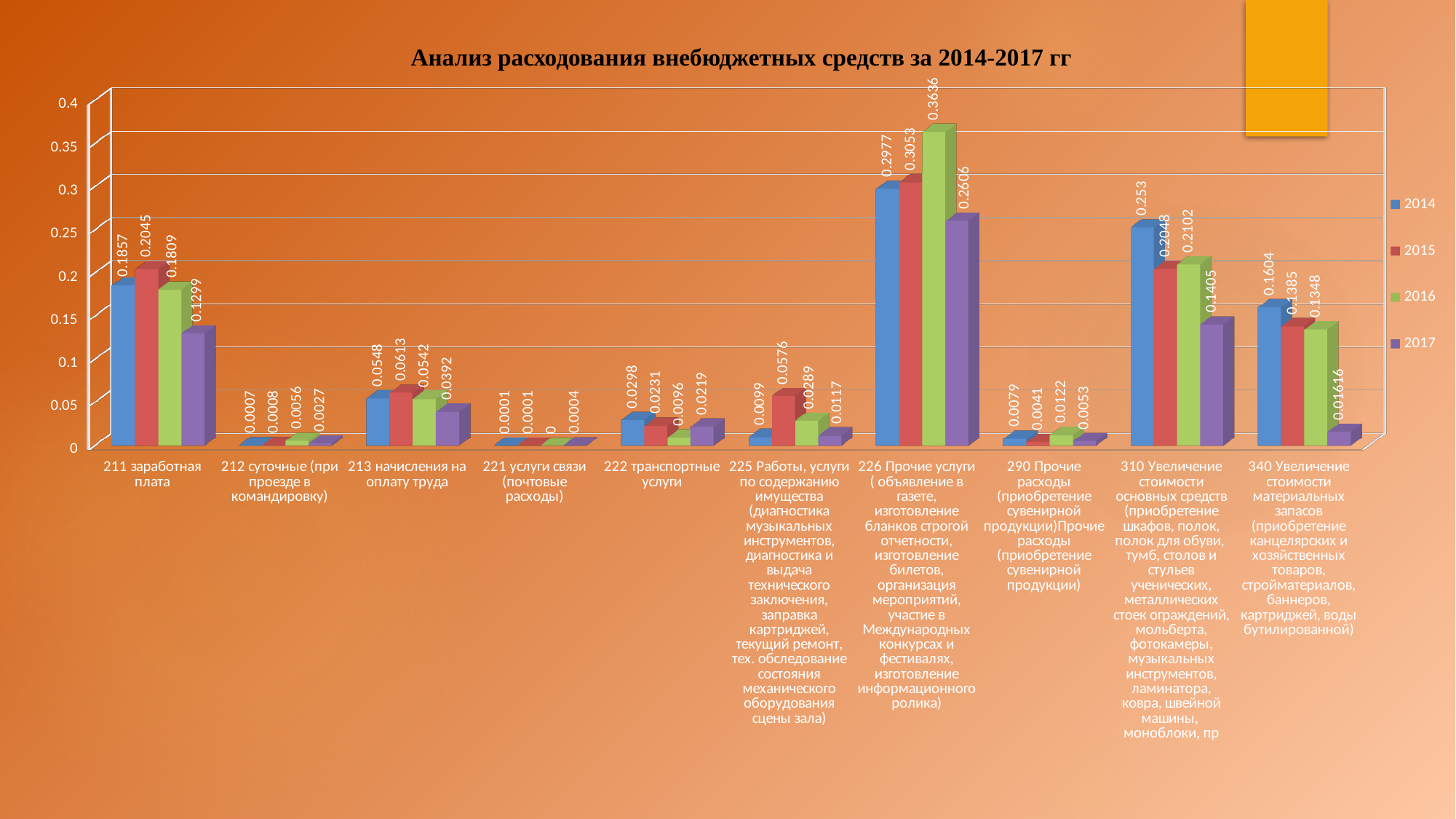
Which category has the highest value for the 2016 series? 226 Прочие услуги What is the value for 2017 in the category "310 Увеличение стоимости основных средств"? 0.1405 What is the value for 2016 in the category "226 Прочие услуги"? 0.3636 What is the difference between the 2015 and 2017 values in the category "211 заработная плата"? 0.0746 What is the value for 2014 in the category "211 заработная плата"? 0.1857 How many series does the legend list? 4 Which category has the lowest value for the 2016 series? 221 услуги связи (почтовые расходы) Is the 2014 value for "310 Увеличение стоимости основных средств" greater or less than 0.2? greater What is the title of the chart? Анализ расходования внебюджетных средств за 2014-2017 гг What kind of chart is shown on the slide? Bar chart In the category "225 Работы, услуги по содержанию имущества", which year has the larger value, 2015 or 2016? 2015 What is the value for 2015 in the category "222 транспортные услуги"? 0.0231